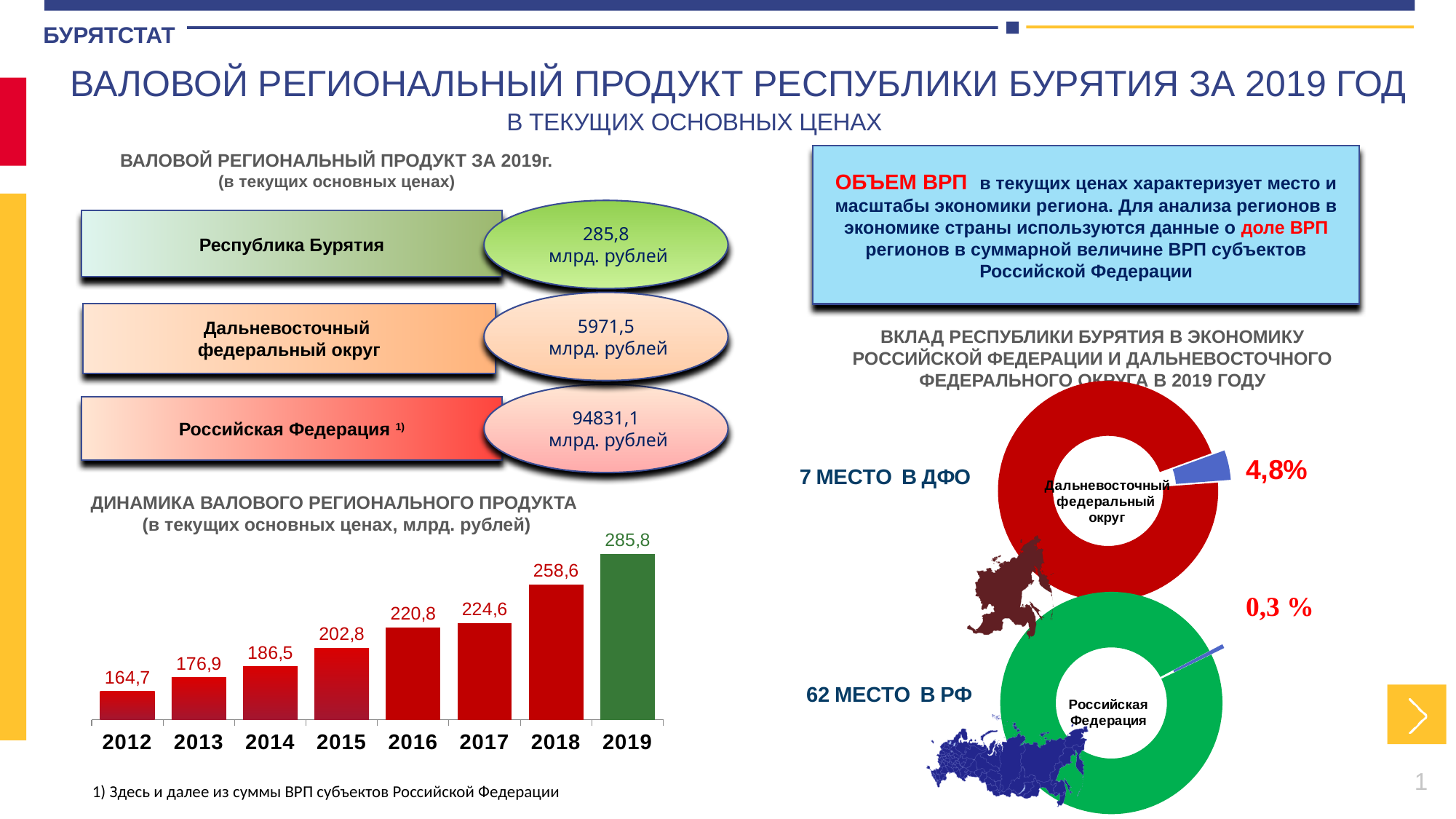
In the chart 'ДИНАМИКА ВАЛОВОГО РЕГИОНАЛЬНОГО ПРОДУКТА', what is the value for 2012? 164,7 In the chart 'ДИНАМИКА ВАЛОВОГО РЕГИОНАЛЬНОГО ПРОДУКТА', which is larger, the value for 2013 or the value for 2017? 2017 In the donut chart for 'Дальневосточный федеральный округ' on the right of the slide, what share is shown for the Republic of Buryatia? 4,8% In the chart 'ДИНАМИКА ВАЛОВОГО РЕГИОНАЛЬНОГО ПРОДУКТА', what is the value for 2016? 220,8 In the chart 'ДИНАМИКА ВАЛОВОГО РЕГИОНАЛЬНОГО ПРОДУКТА', what is the difference between the values for 2015 and 2014? 16,3 In the chart 'ДИНАМИКА ВАЛОВОГО РЕГИОНАЛЬНОГО ПРОДУКТА', what is the difference between the values for 2019 and 2018? 27,2 How many years are shown in the chart 'ДИНАМИКА ВАЛОВОГО РЕГИОНАЛЬНОГО ПРОДУКТА'? 8 In the chart 'ДИНАМИКА ВАЛОВОГО РЕГИОНАЛЬНОГО ПРОДУКТА', do the values rise or fall from 2012 to 2019? rise In the chart 'ДИНАМИКА ВАЛОВОГО РЕГИОНАЛЬНОГО ПРОДУКТА', which year has the lowest value? 2012 In the chart 'ДИНАМИКА ВАЛОВОГО РЕГИОНАЛЬНОГО ПРОДУКТА', which year has the highest value? 2019 In the chart 'ДИНАМИКА ВАЛОВОГО РЕГИОНАЛЬНОГО ПРОДУКТА', what is the value for 2018? 258,6 What kind of chart is 'ДИНАМИКА ВАЛОВОГО РЕГИОНАЛЬНОГО ПРОДУКТА'? bar chart